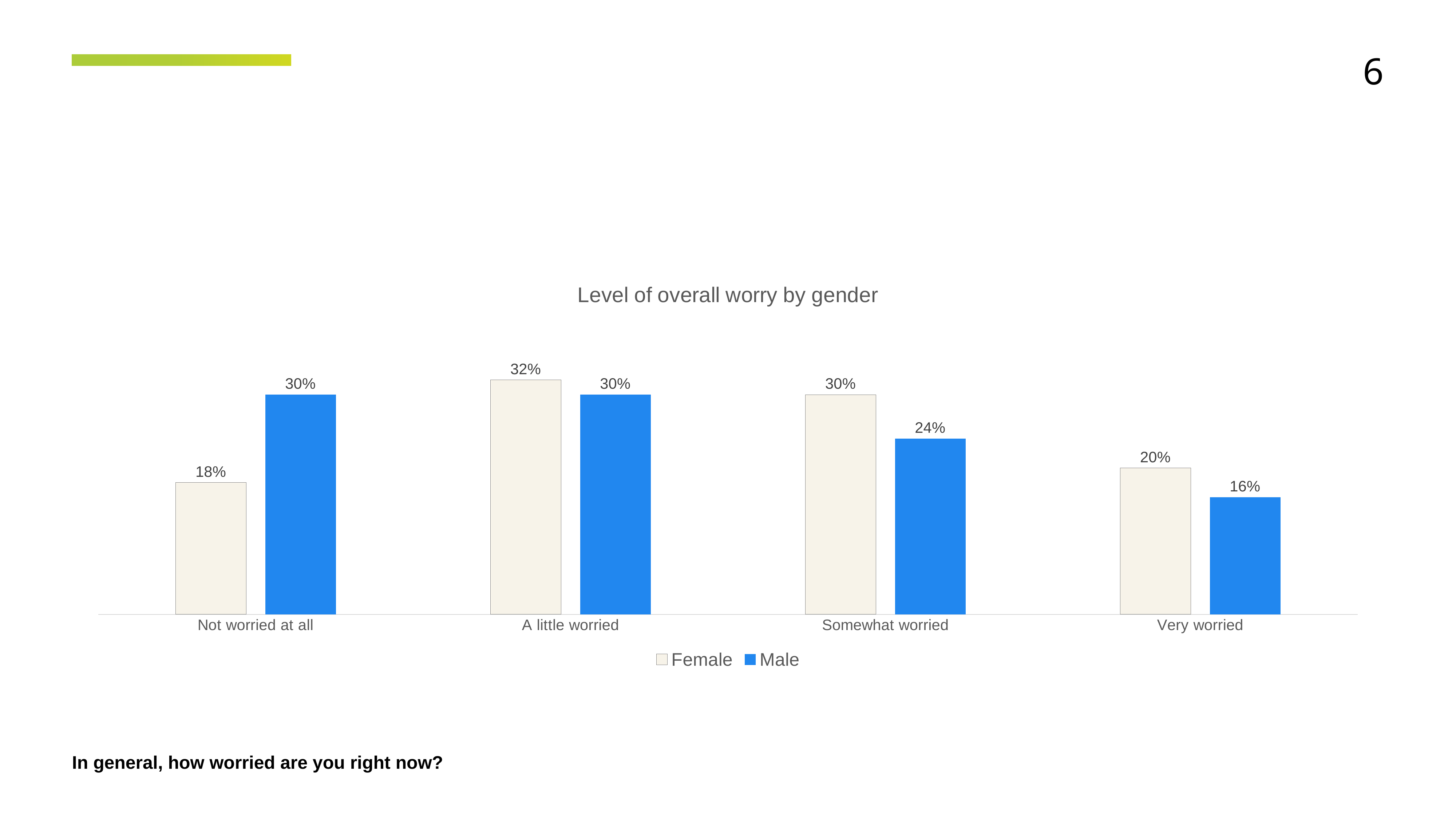
What is the Male value for "Very worried"? 16% What is the title of the chart? Level of overall worry by gender For "Somewhat worried", which is larger, the Female value or the Male value? Female What kind of chart is shown on the slide? Bar chart What is the Male value for "Somewhat worried"? 24% How many series does the legend list? 2 What is the Female value for "Not worried at all"? 18% Which category has the lowest Male value? Very worried Which category has the highest Female value? A little worried How many categories are shown on the x axis? 4 What is the Female value for "A little worried"? 32% What is the difference between the Male and Female values for "Not worried at all"? 12%